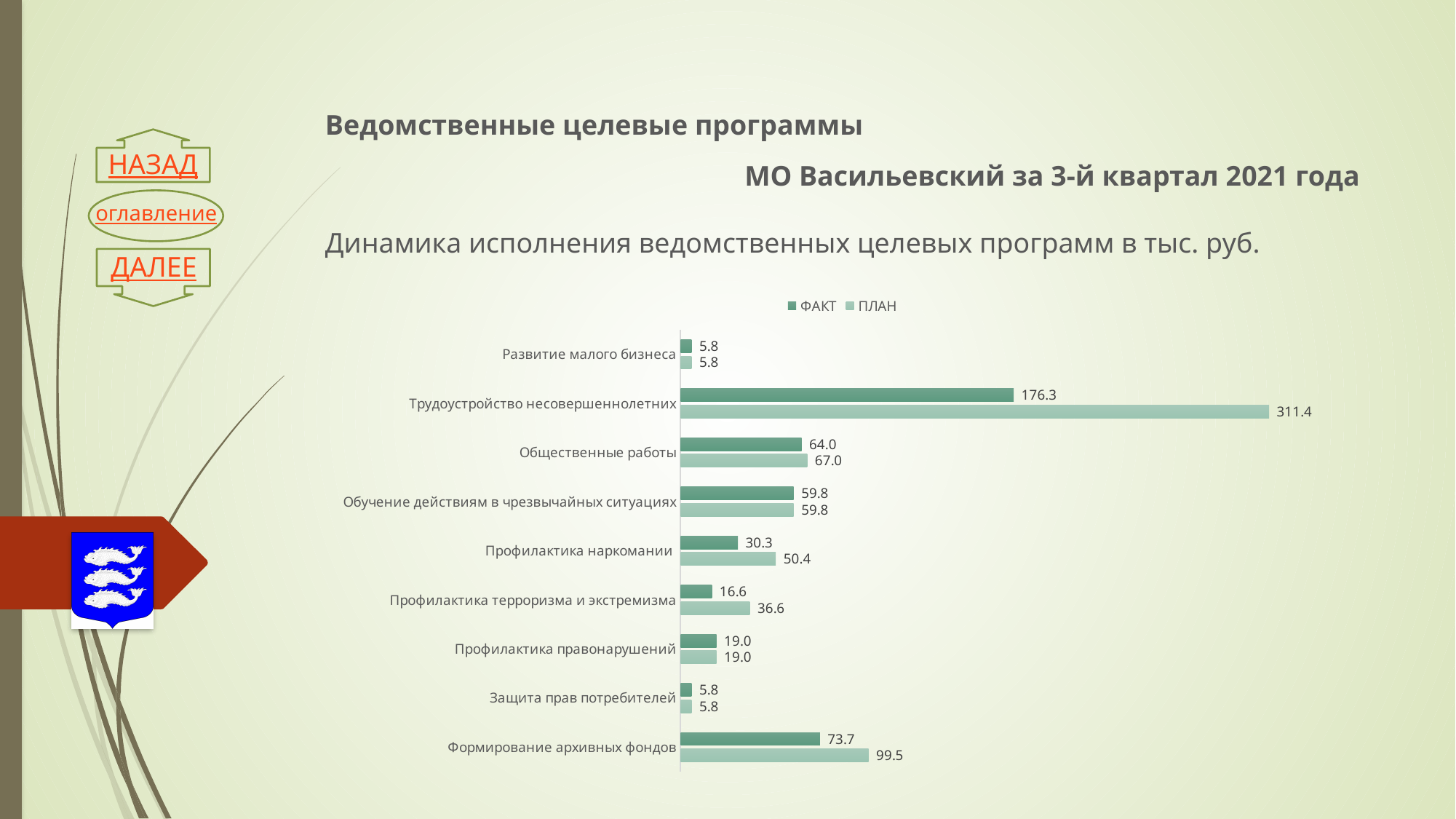
What is the ПЛАН value for Профилактика наркомании? 50.4 What is the ФАКТ value for Формирование архивных фондов? 73.7 Which is larger for Общественные работы: the ФАКТ value or the ПЛАН value? ПЛАН What kind of chart is shown on the slide? Bar chart Which category has the highest ПЛАН value? Трудоустройство несовершеннолетних How many categories are shown in the chart? 9 What is the difference between the ПЛАН and ФАКТ values for Профилактика терроризма и экстремизма? 20.0 Which category has the lowest ФАКТ value? Развитие малого бизнеса and Защита прав потребителей (both 5.8) What are the two series named in the legend? ФАКТ and ПЛАН What is the ФАКТ value for Трудоустройство несовершеннолетних? 176.3 How many series does the legend list? 2 What is the ПЛАН value for Трудоустройство несовершеннолетних? 311.4